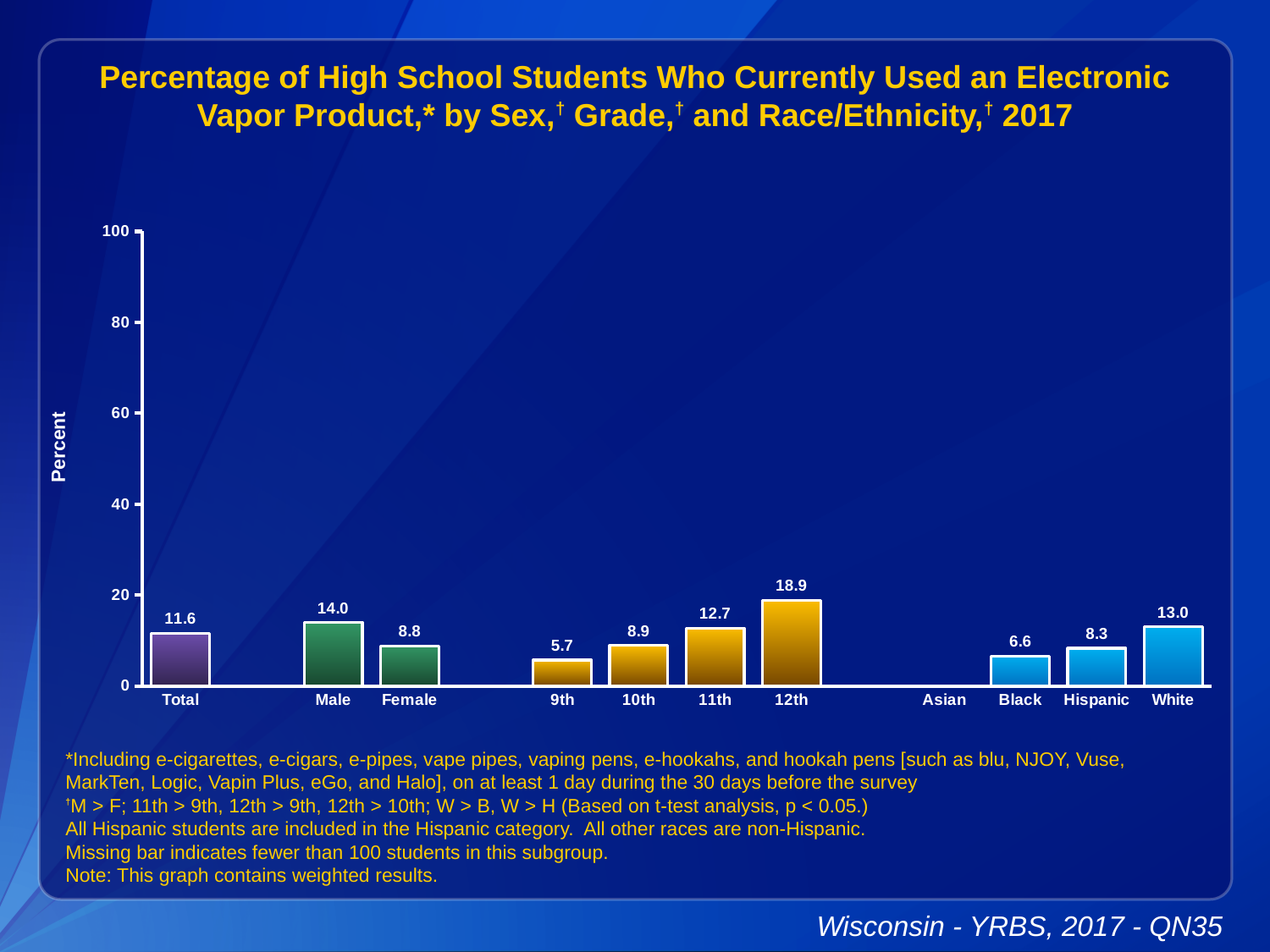
What is the value for 12th grade? 18.9 Which is larger, the value for White or the value for Black? White What is the value for Male? 14.0 What kind of chart is shown? bar chart What is the value for Total? 11.6 Which category on the x axis has no bar? Asian What is the difference between the Male and Female values? 5.2 Which category has the highest value? 12th Is the value for 12th grade greater or less than 20? less Which category with a bar has the lowest value? 9th What is the value for Hispanic? 8.3 How many categories are labeled on the x axis? 11